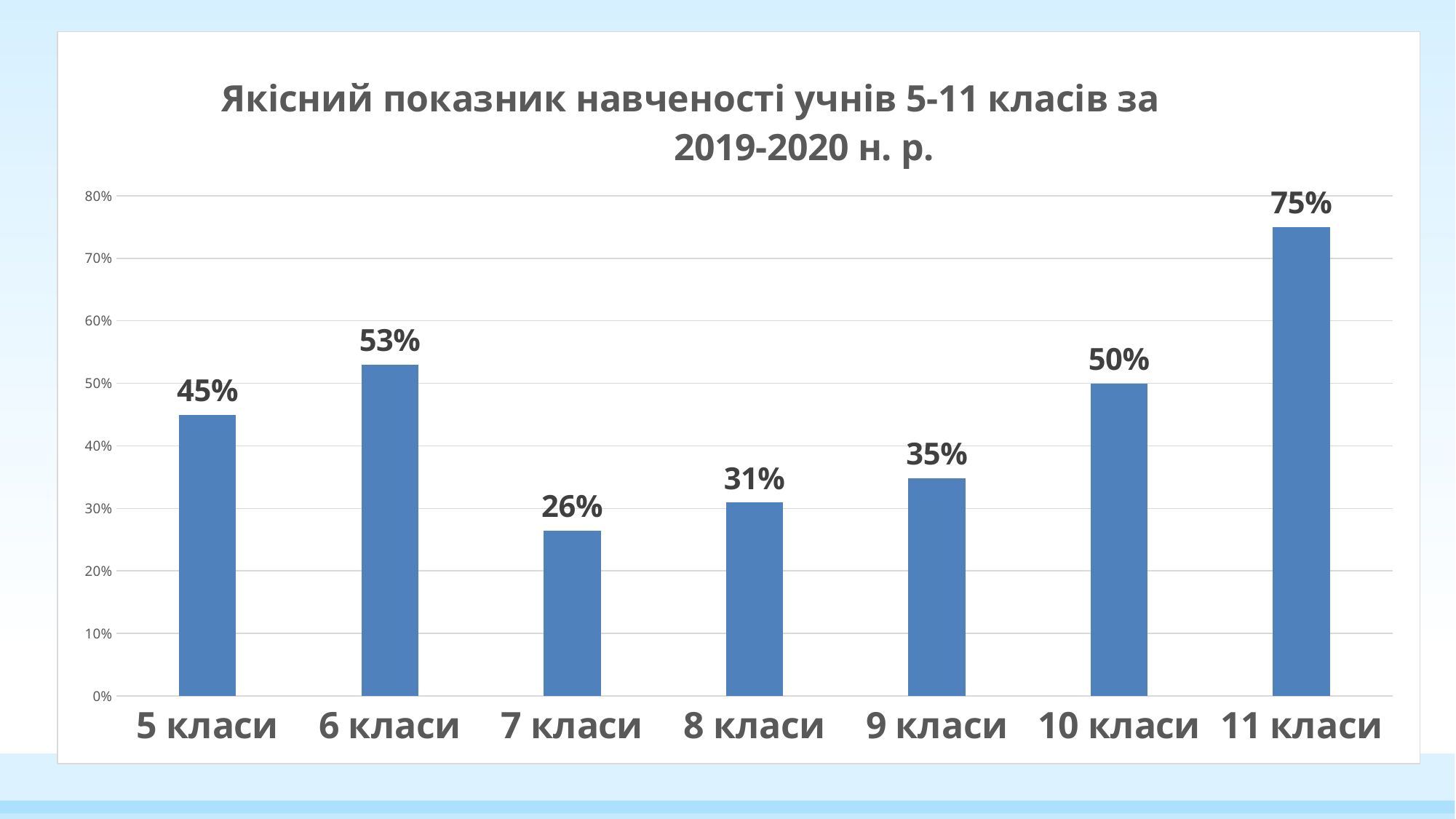
What is the value for 7 класи? 26% Which category has the highest value? 11 класи Is the value for 6 класи greater or less than 50%? greater How many categories are shown on the x axis? 7 Which is larger, the value for 8 класи or the value for 9 класи? 9 класи What is the difference between the values for 6 класи and 9 класи? 18% What kind of chart is shown on the slide? bar chart What is the difference between the values for 11 класи and 5 класи? 30% What is the value for 10 класи? 50% Which category has the lowest value? 7 класи Do the values rise or fall from 7 класи to 11 класи? rise What is the title of the chart? Якісний показник навченості учнів 5-11 класів за 2019-2020 н. р.